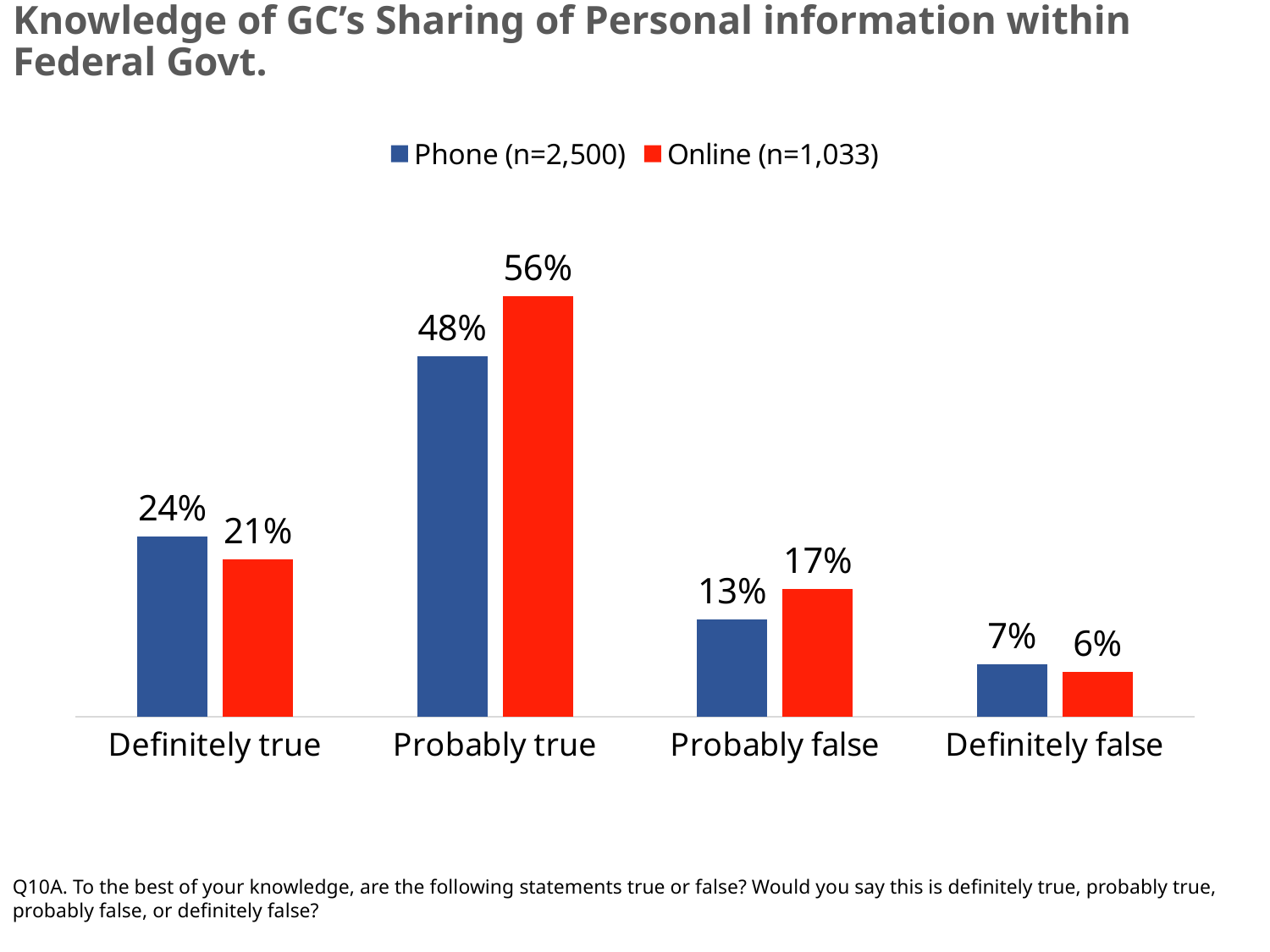
What is the difference between the Phone and Online values for Definitely true? 3% Which category has the lowest Phone value? Definitely false What is the sample size for the Online series shown in the legend? n=1,033 What is the Online value for Probably false? 17% What kind of chart is shown on the slide? Bar chart What is the difference between the Online and Phone values for Probably true? 8% Which is larger for Probably false, the Phone value or the Online value? Online Which category has the highest Online value? Probably true How many categories are shown on the x axis? 4 What is the Online value for Definitely false? 6% How many series does the legend list? 2 What is the Phone value for Probably true? 48%